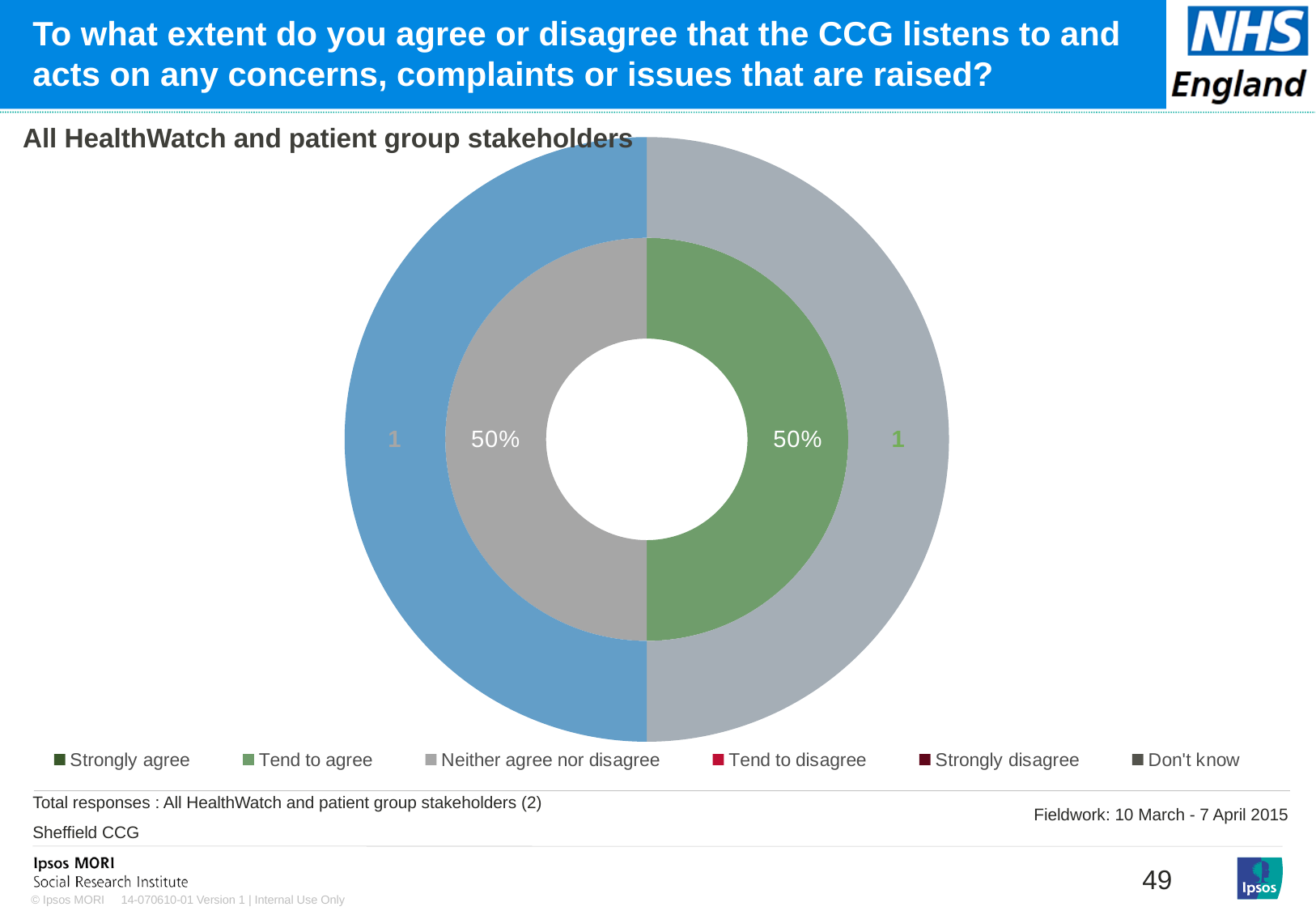
Which group of stakeholders does the chart cover, according to the chart heading? All HealthWatch and patient group stakeholders What number is shown on the outer ring for the 'Neither agree nor disagree' segment? 1 What percentage of respondents answered 'Tend to agree'? 50% What kind of chart is shown on the slide? doughnut chart What is the difference between the 'Tend to agree' share and the 'Neither agree nor disagree' share? 0 percentage points How many segments does the inner ring of the doughnut chart contain? 2 Which is larger, the share for 'Tend to agree' or the share for 'Neither agree nor disagree'? They are equal (both 50%) How many response options does the legend list? 6 What number is shown on the outer ring for the 'Tend to agree' segment? 1 What colour represents 'Tend to agree' in the legend? green What percentage of respondents answered 'Neither agree nor disagree'? 50% What do the 'Tend to agree' and 'Neither agree nor disagree' shares add up to? 100%